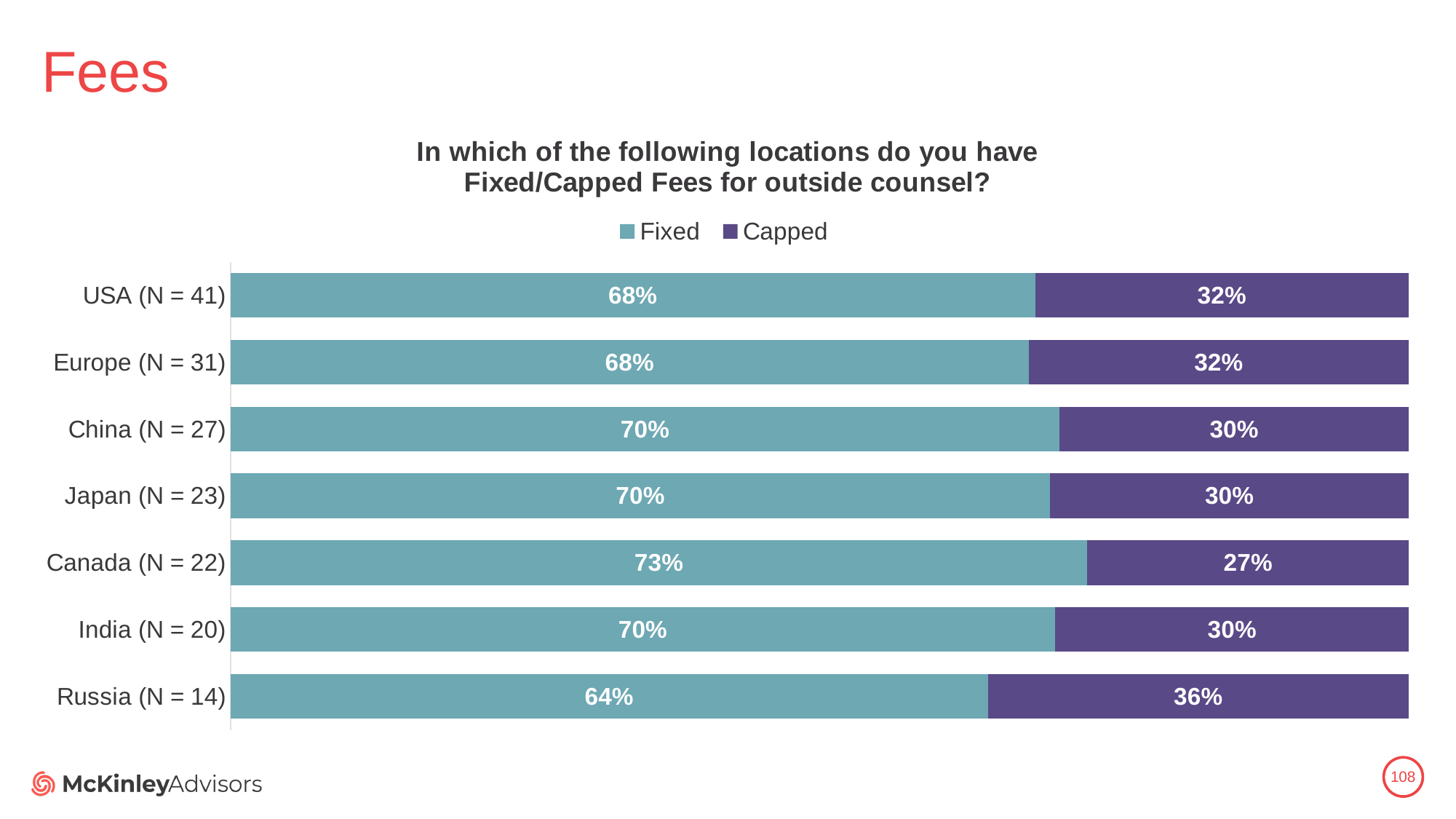
Which location has the highest Fixed value? Canada (N = 22) Which is larger, the Capped value for USA (N = 41) or the Capped value for Canada (N = 22)? USA (N = 41) What is the Fixed value for USA (N = 41)? 68% What is the Fixed value for Canada (N = 22)? 73% Which location has the highest Capped value? Russia (N = 14) What is the Capped value for Japan (N = 23)? 30% What kind of chart is shown on the slide? Stacked bar chart How many series does the legend list? 2 Which location has the lowest Fixed value? Russia (N = 14) What is the difference between the Fixed values for Canada (N = 22) and Russia (N = 14)? 9% How many locations are shown in the chart? 7 What is the Capped value for Russia (N = 14)? 36%